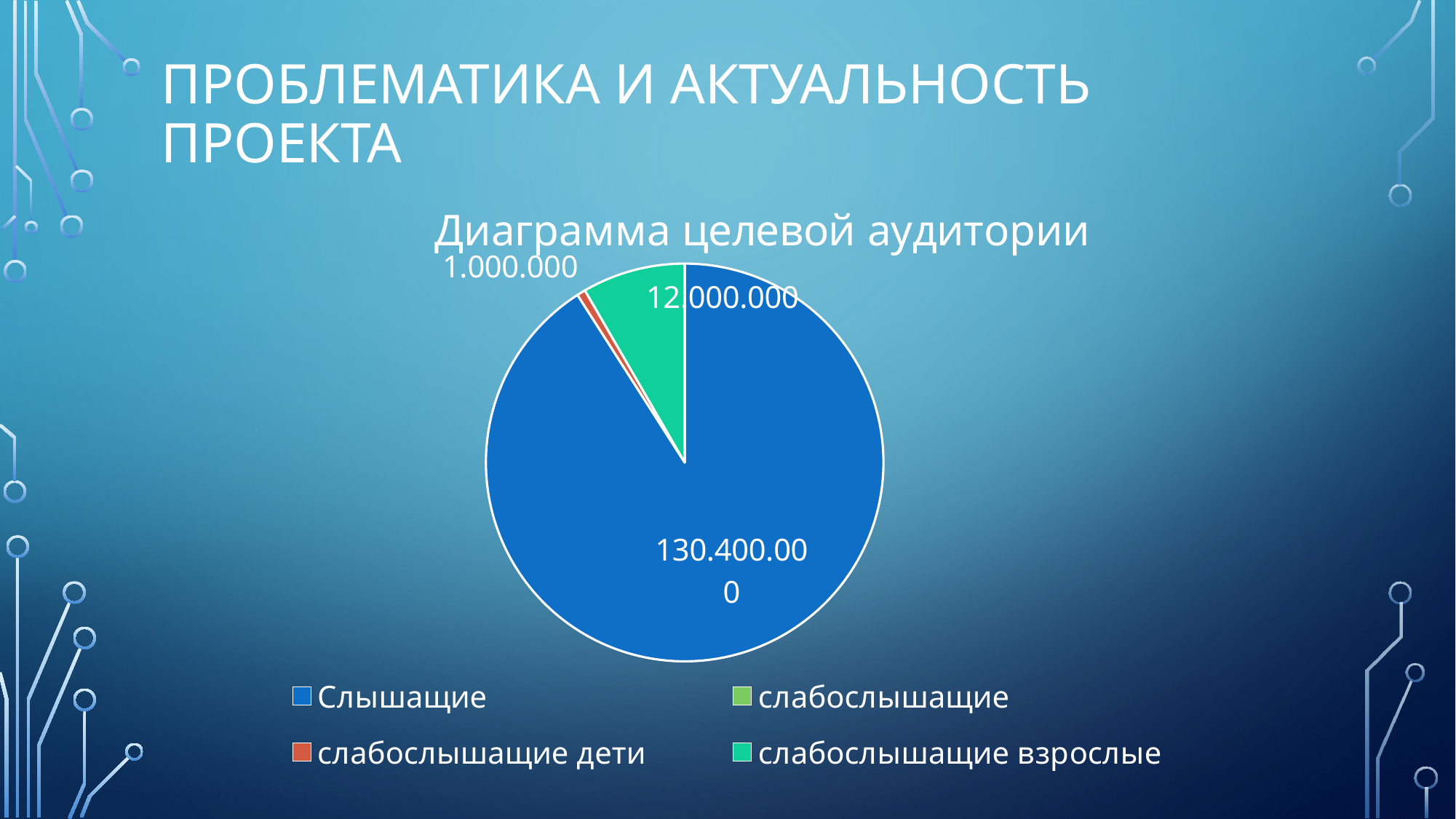
What is the value for слабослышащие взрослые in the pie chart? 12.000.000 What is the value for Слышащие in the pie chart? 130.400.000 What kind of chart is shown on the slide? Pie chart What is the title of the chart? Диаграмма целевой аудитории What is the value for слабослышащие дети in the pie chart? 1.000.000 Which is larger: the value for слабослышащие взрослые or the value for слабослышащие дети? слабослышащие взрослые Which category has the largest slice of the pie? Слышащие What is the difference between the values for слабослышащие взрослые and слабослышащие дети? 11.000.000 What colour is the slice for Слышащие? Blue What is the difference between the values for Слышащие and слабослышащие взрослые? 118.400.000 How many entries does the chart legend list? 4 Which labelled slice is the smallest in the pie chart? слабослышащие дети